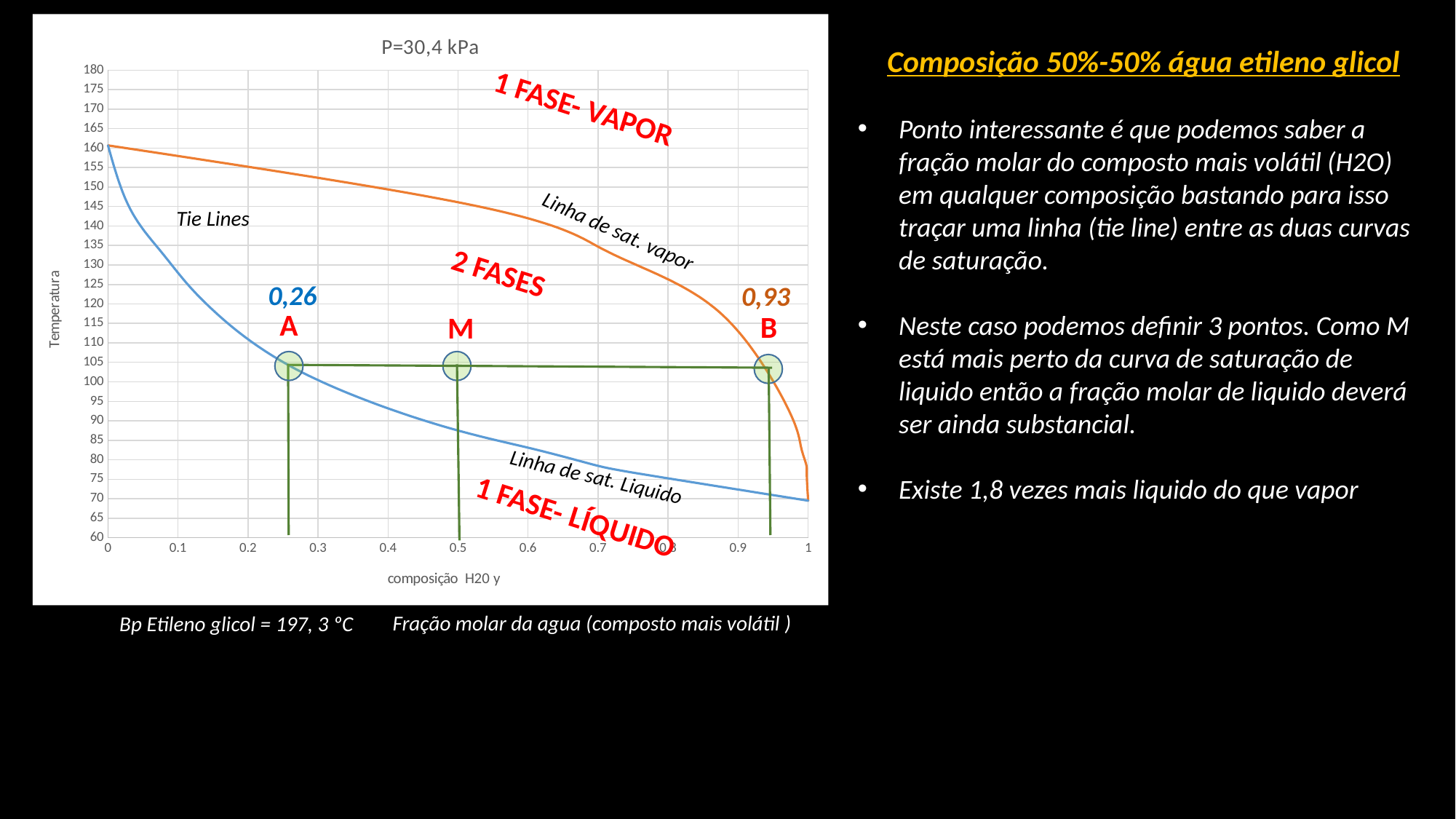
Is the temperature of the 'Linha de sat. Liquido' curve at composition 0.5 greater or less than 100? less How many saturation curves are plotted on the chart? 2 Is the temperature of the tie line through points A, M and B greater or less than 110? less Is the temperature of the 'Linha de sat. vapor' curve at composition 0.5 greater or less than 140? greater What kind of chart is shown on the slide? line chart Does the 'Linha de sat. vapor' curve rise or fall as the composition increases from 0 to 1? fall What composition value is labelled at point A on the chart? 0,26 What composition value is labelled at point B on the chart? 0,93 Does the 'Linha de sat. Liquido' curve rise or fall as the composition increases from 0 to 1? fall What is the label of the x axis of the chart? composição H20 y At composition 0.5, which curve is higher, 'Linha de sat. vapor' or 'Linha de sat. Liquido'? Linha de sat. vapor What is the title of the chart? P=30,4 kPa